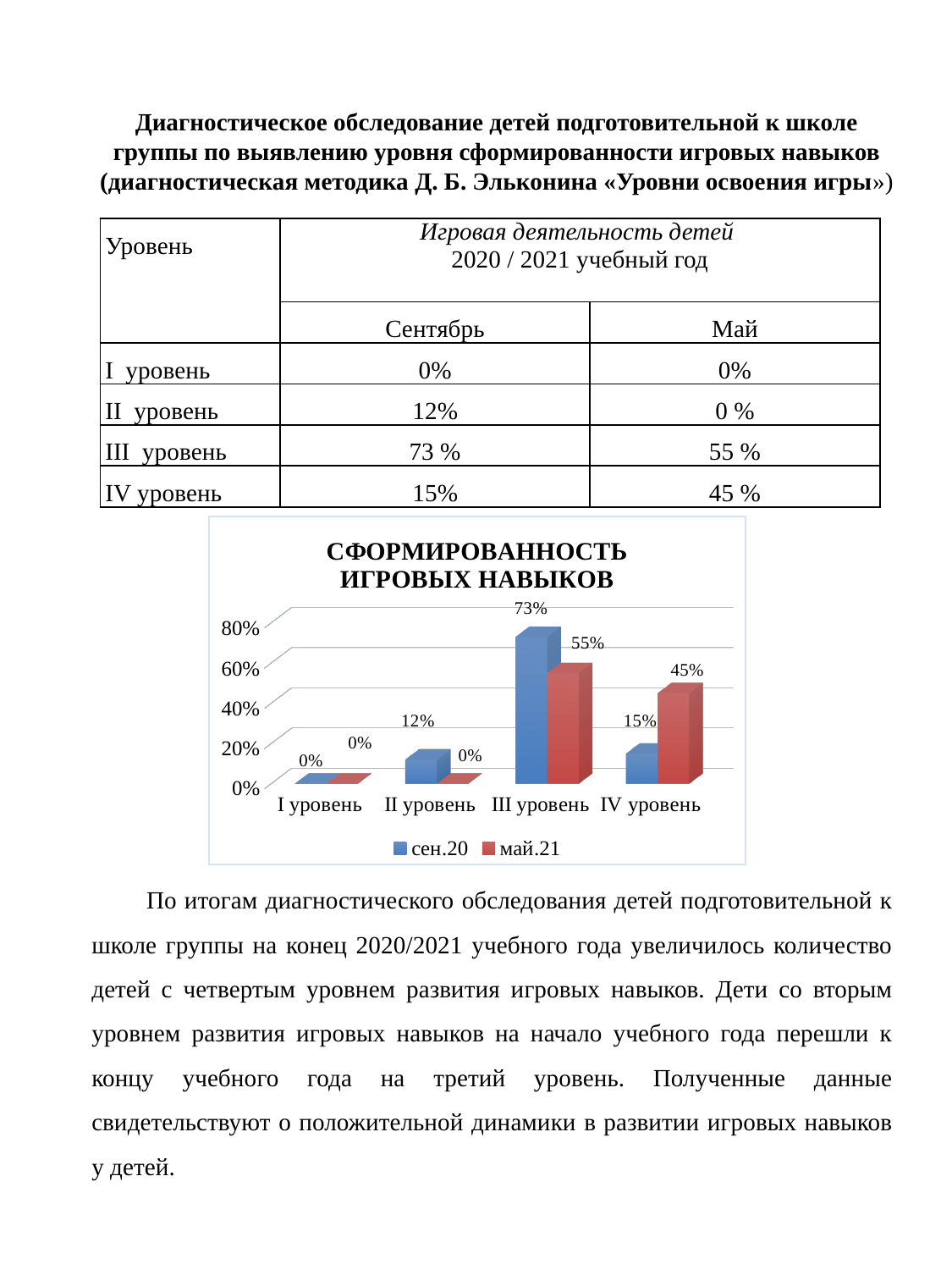
For IV уровень, which series has the larger value, сен.20 or май.21? май.21 What is the difference between the май.21 and сен.20 values for IV уровень? 30% What is the difference between the сен.20 and май.21 values for III уровень? 18% What is the value for II уровень in the май.21 series? 0% What type of chart is shown on the slide? bar chart How many series does the chart legend list? 2 How many categories are shown on the x axis of the chart? 4 What is the value for II уровень in the сен.20 series? 12% Which category has the highest value in the сен.20 series? III уровень Which category has the highest value in the май.21 series? III уровень What is the value for IV уровень in the май.21 series? 45% What is the value for III уровень in the сен.20 series? 73%